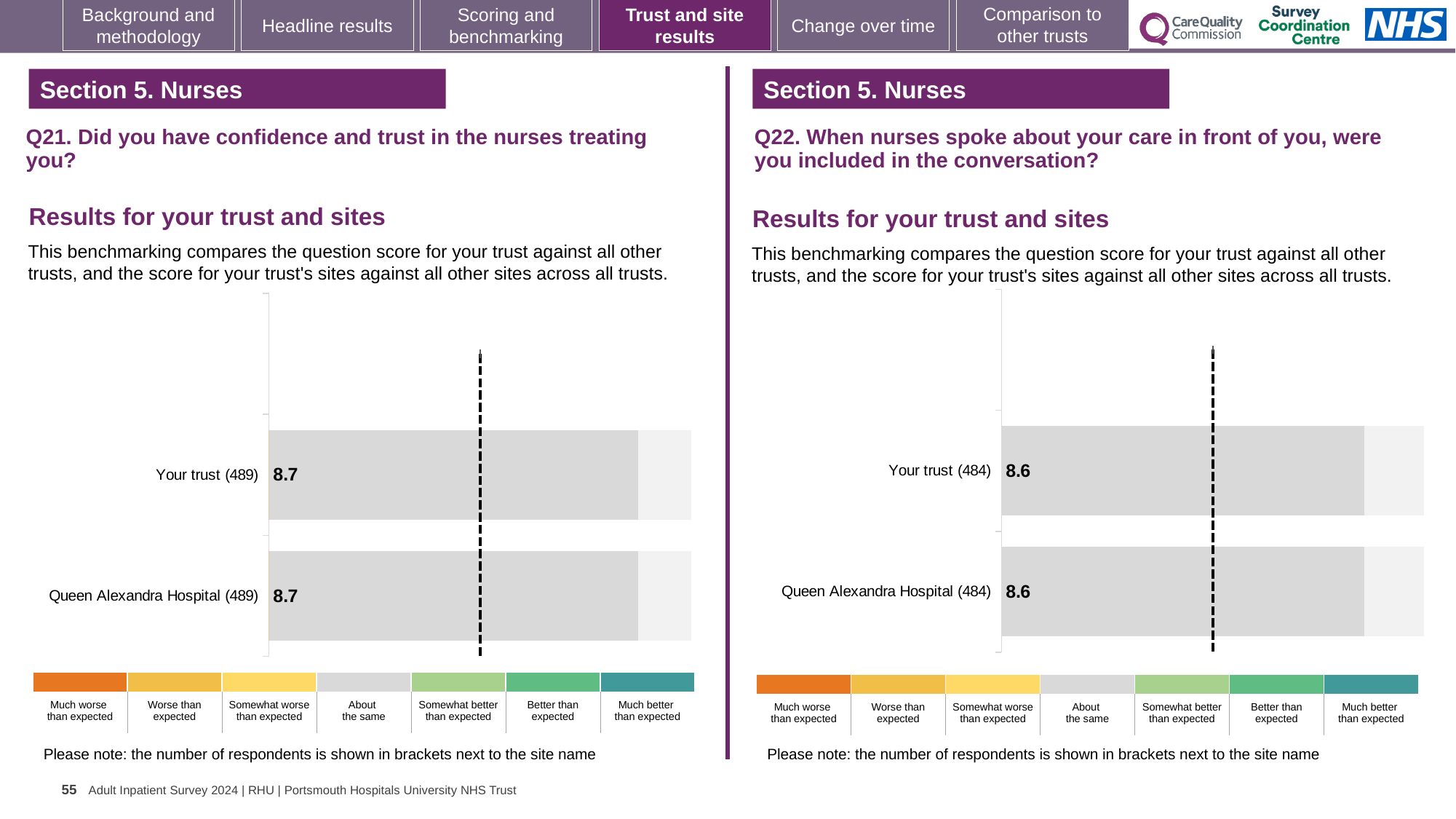
How many bars are plotted in the Q22 chart on the right? 2 In the Q22 chart on the right, what is the difference between the score for Your trust and the score for Queen Alexandra Hospital? 0 In the Q21 chart on the left, what is the difference between the score for Your trust and the score for Queen Alexandra Hospital? 0 What type of chart is used for the Q21 results on the left? Bar chart In the Q21 chart on the left, what is the score for Queen Alexandra Hospital? 8.7 How many bars are plotted in the Q21 chart on the left? 2 In the Q21 chart on the left, how many respondents are shown in brackets next to Your trust? 489 In the Q22 chart on the right, what is the score for Your trust? 8.6 In the Q21 chart on the left, what is the score for Your trust? 8.7 In the Q22 chart on the right, what is the score for Queen Alexandra Hospital? 8.6 In the Q22 chart on the right, how many respondents are shown in brackets next to Queen Alexandra Hospital? 484 Is the score for Your trust in the Q22 chart on the right larger or smaller than the score for Your trust in the Q21 chart on the left? Smaller